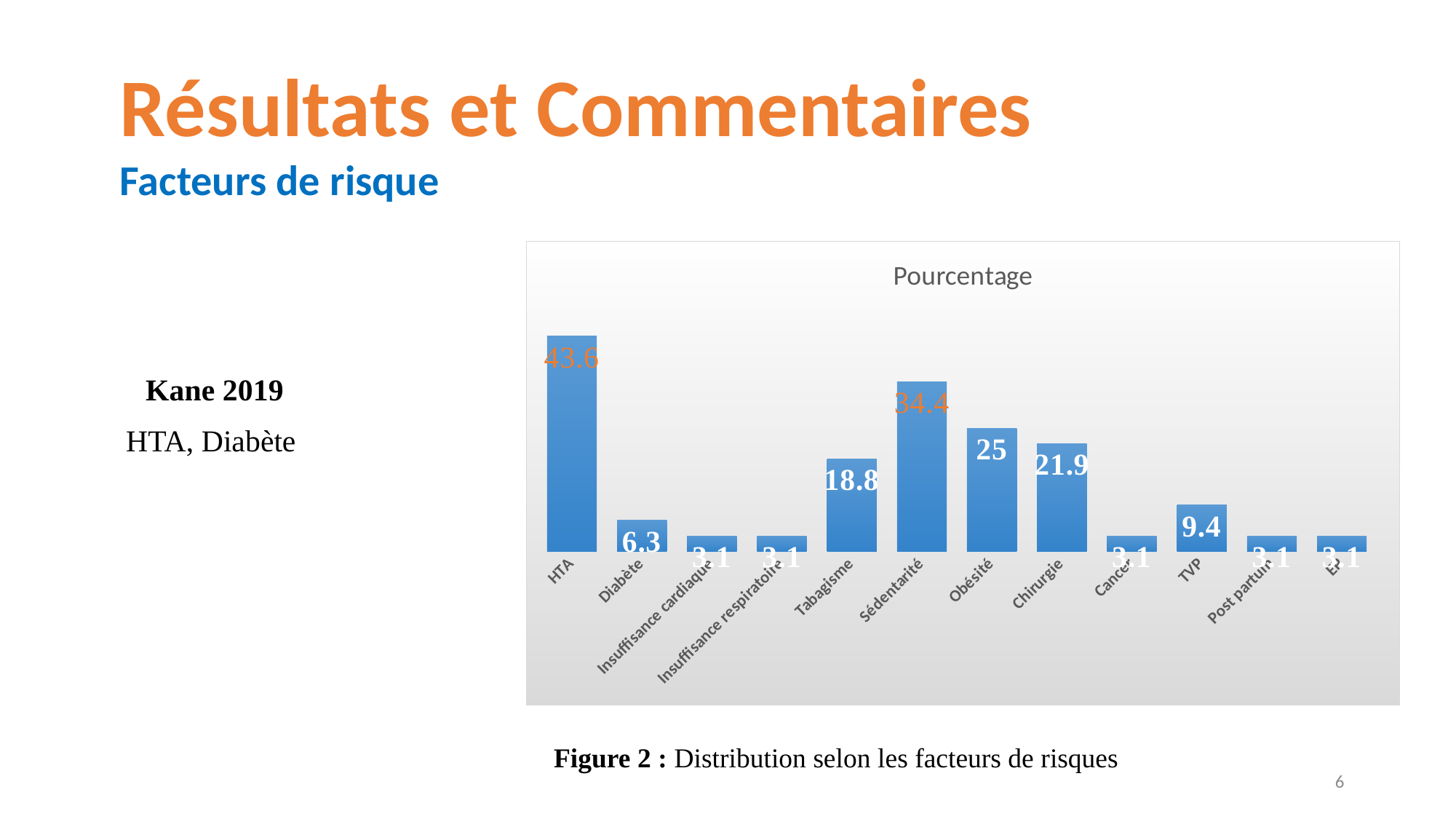
What is the difference between the values for HTA and Sédentarité? 9.2 What type of chart is shown on the slide? Bar chart What is the lowest value shown in the chart? 3.1 What is the value for HTA in the chart? 43.6 How many categories are shown in the chart? 12 Which is larger, the value for Obésité or the value for Chirurgie? Obésité What is the value for TVP in the chart? 9.4 What is the value for Chirurgie in the chart? 21.9 What is the value for Tabagisme in the chart? 18.8 What is the value for Sédentarité in the chart? 34.4 Which category has the highest value in the chart? HTA What is the difference between the values for Obésité and Diabète? 18.7